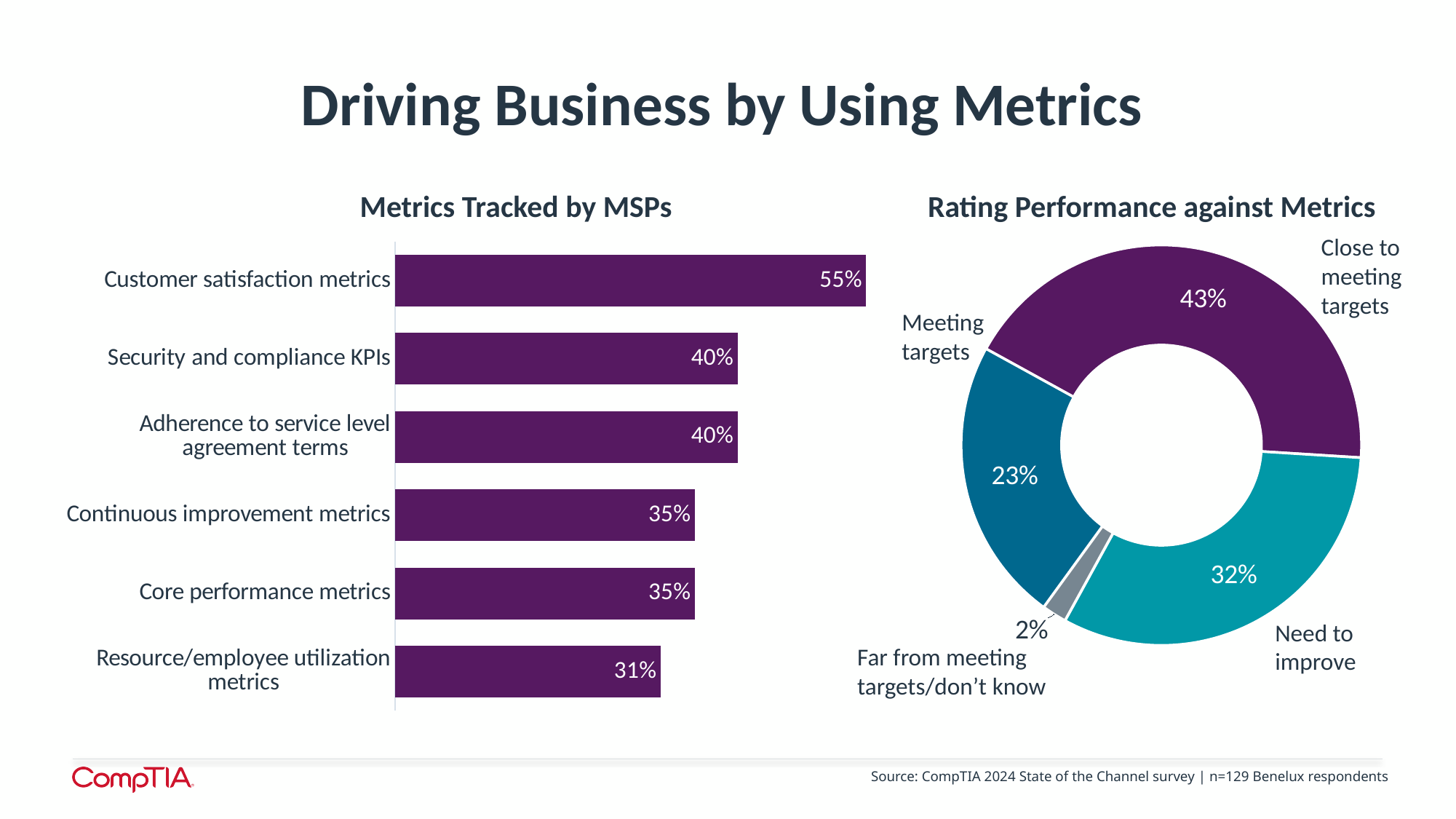
In the 'Rating Performance against Metrics' chart, how many slices are there? 4 In the 'Rating Performance against Metrics' chart, which category has the smallest share? Far from meeting targets/don't know In the 'Rating Performance against Metrics' chart, which is larger: 'Need to improve' or 'Meeting targets'? Need to improve In the 'Metrics Tracked by MSPs' chart, which category has the highest value? Customer satisfaction metrics In the 'Rating Performance against Metrics' chart, what is the value for 'Meeting targets'? 23% In the 'Metrics Tracked by MSPs' chart, which category has the lowest value? Resource/employee utilization metrics In the 'Metrics Tracked by MSPs' chart, how many categories are shown? 6 What kind of chart is 'Metrics Tracked by MSPs'? Bar chart In the 'Metrics Tracked by MSPs' chart, what is the value for Customer satisfaction metrics? 55% In the 'Rating Performance against Metrics' chart, what share is 'Close to meeting targets'? 43% In the 'Metrics Tracked by MSPs' chart, what is the value for Resource/employee utilization metrics? 31% In the 'Metrics Tracked by MSPs' chart, what is the difference between Customer satisfaction metrics and Security and compliance KPIs? 15%